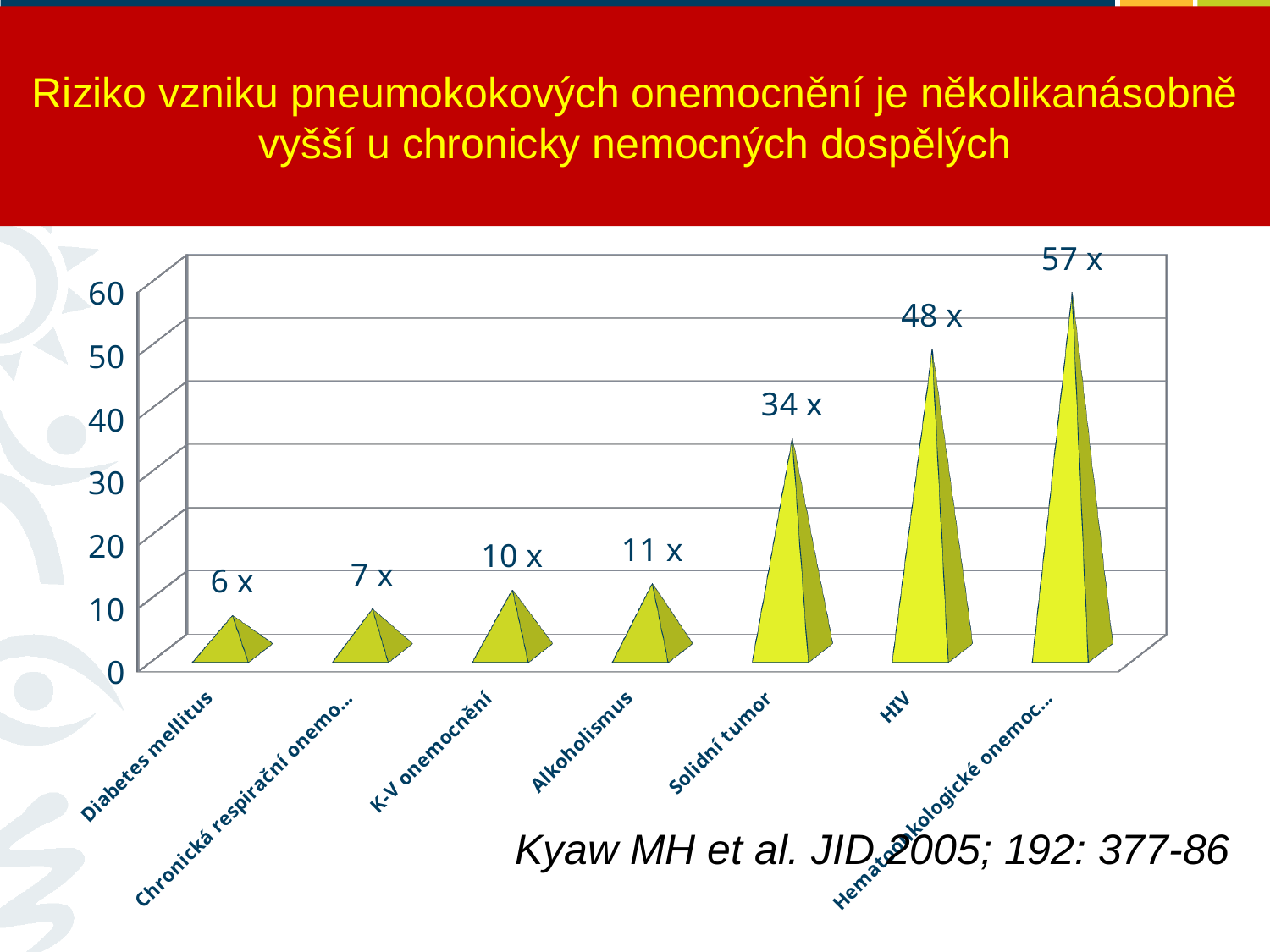
Which category has the lowest value? Diabetes mellitus Which is larger, the value for Alkoholismus or the value for K-V onemocnění? Alkoholismus What is the difference between the values for HIV and Solidní tumor? 14 x What kind of chart is shown on the slide? Bar chart How many categories are shown on the x axis? 7 Which category has the highest value? Hematoonkologické onemoc… What is the value shown for Diabetes mellitus? 6 x Do the values rise or fall from left to right along the x axis? Rise What is the value shown for Alkoholismus? 11 x What is the value shown for K-V onemocnění? 10 x What is the value shown for Solidní tumor? 34 x What is the value shown for HIV? 48 x